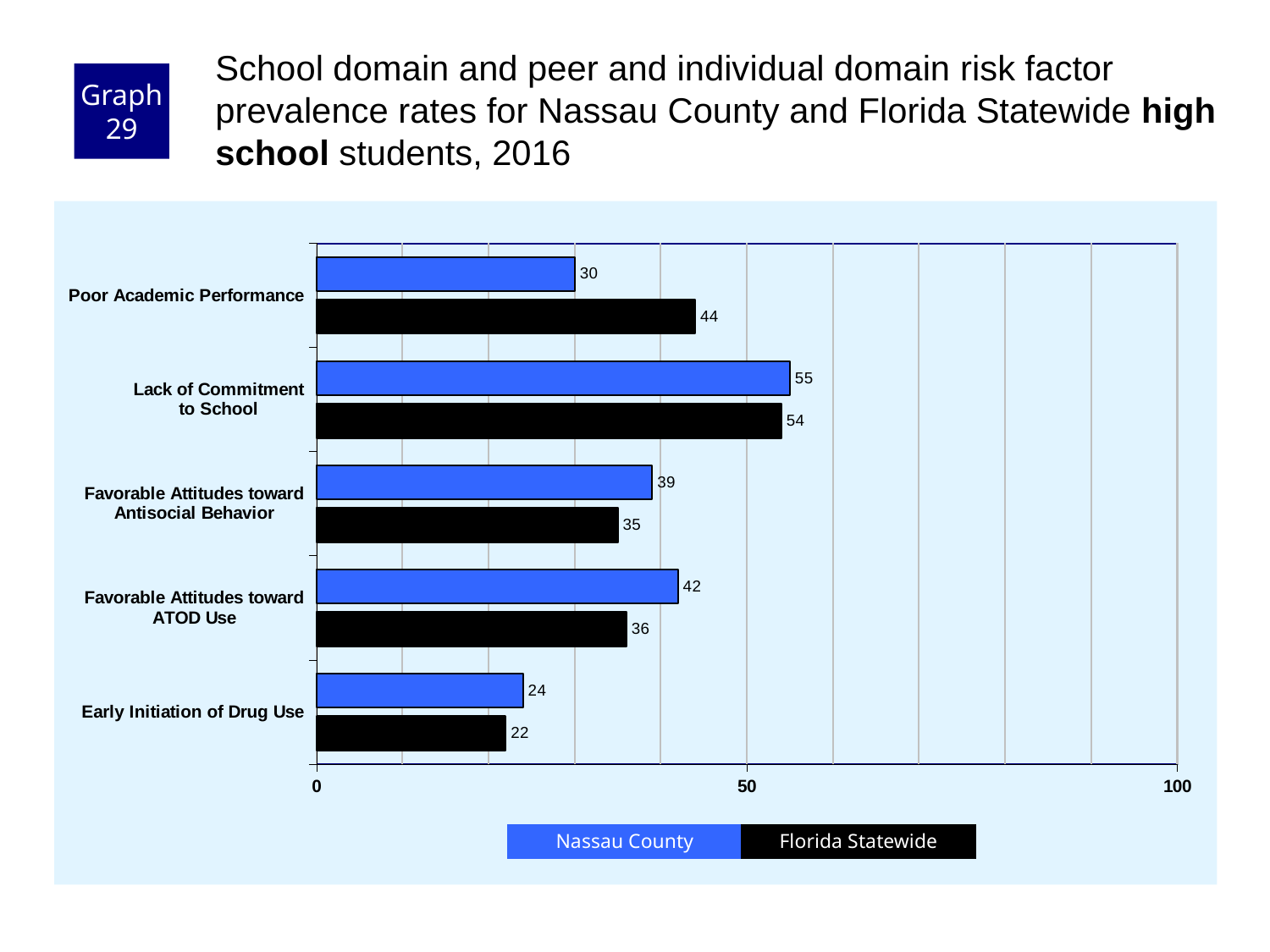
What is the Florida Statewide value for Favorable Attitudes toward ATOD Use? 36 What is the difference between the Florida Statewide and Nassau County values for Poor Academic Performance? 14 Which is larger for Favorable Attitudes toward Antisocial Behavior: the Nassau County value or the Florida Statewide value? Nassau County Which colour represents Florida Statewide in the chart? black What is the Nassau County value for Early Initiation of Drug Use? 24 How many series does the legend list? 2 Which category has the highest Nassau County value? Lack of Commitment to School How many risk factor categories are shown on the chart? 5 What is the Nassau County value for Poor Academic Performance? 30 What kind of chart is shown on the slide? bar chart Is the Florida Statewide value for Lack of Commitment to School greater or less than 50? greater Which category has the lowest Florida Statewide value? Early Initiation of Drug Use